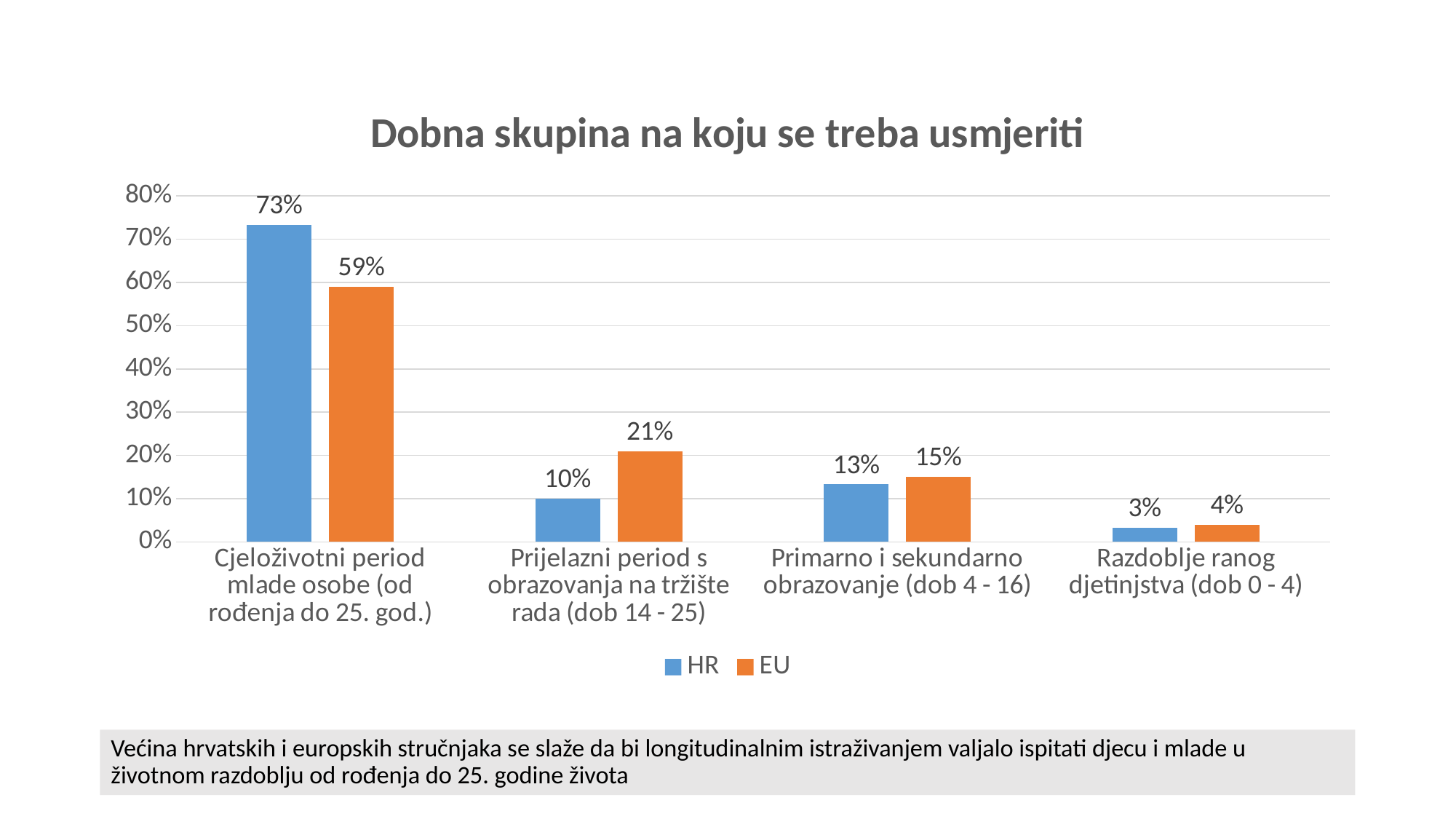
What is the HR value for "Cjeloživotni period mlade osobe (od rođenja do 25. god.)"? 73% How many categories are shown on the x axis? 4 What kind of chart is shown on the slide? Bar chart For "Primarno i sekundarno obrazovanje (dob 4 - 16)", which series has the larger value, HR or EU? EU How many series does the legend list? 2 What is the HR value for "Razdoblje ranog djetinjstva (dob 0 - 4)"? 3% What is the title of the chart? Dobna skupina na koju se treba usmjeriti What is the difference between the HR and EU values for "Cjeloživotni period mlade osobe (od rođenja do 25. god.)"? 14% Which category has the highest EU value? Cjeloživotni period mlade osobe (od rođenja do 25. god.) Is the EU value for "Cjeloživotni period mlade osobe (od rođenja do 25. god.)" greater or less than 50%? greater Which category has the lowest HR value? Razdoblje ranog djetinjstva (dob 0 - 4) What is the EU value for "Prijelazni period s obrazovanja na tržište rada (dob 14 - 25)"? 21%